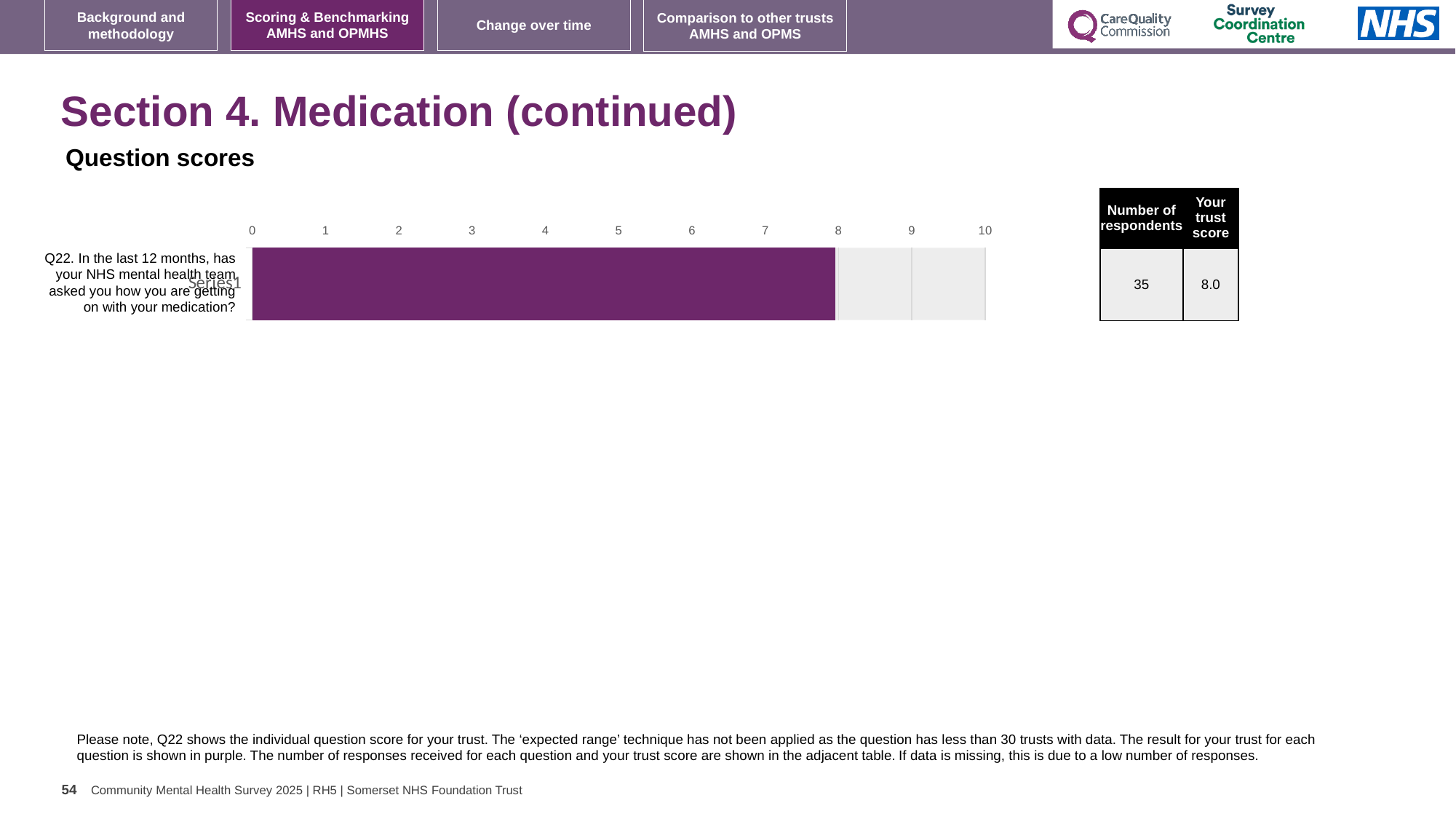
How many questions (categories) are plotted in the chart? 1 Is the value for Q22 greater or less than 9? less Which question number is plotted in the chart? Q22 What value on the axis does the bar for Q22 reach? 8 What is the trust score for Q22 shown in the adjacent table? 8.0 What colour is the bar for Q22? purple Is the value for Q22 greater or less than 5? greater What is the maximum value shown on the chart's axis? 10 What kind of chart is shown on the slide? bar chart How many respondents answered Q22 according to the table? 35